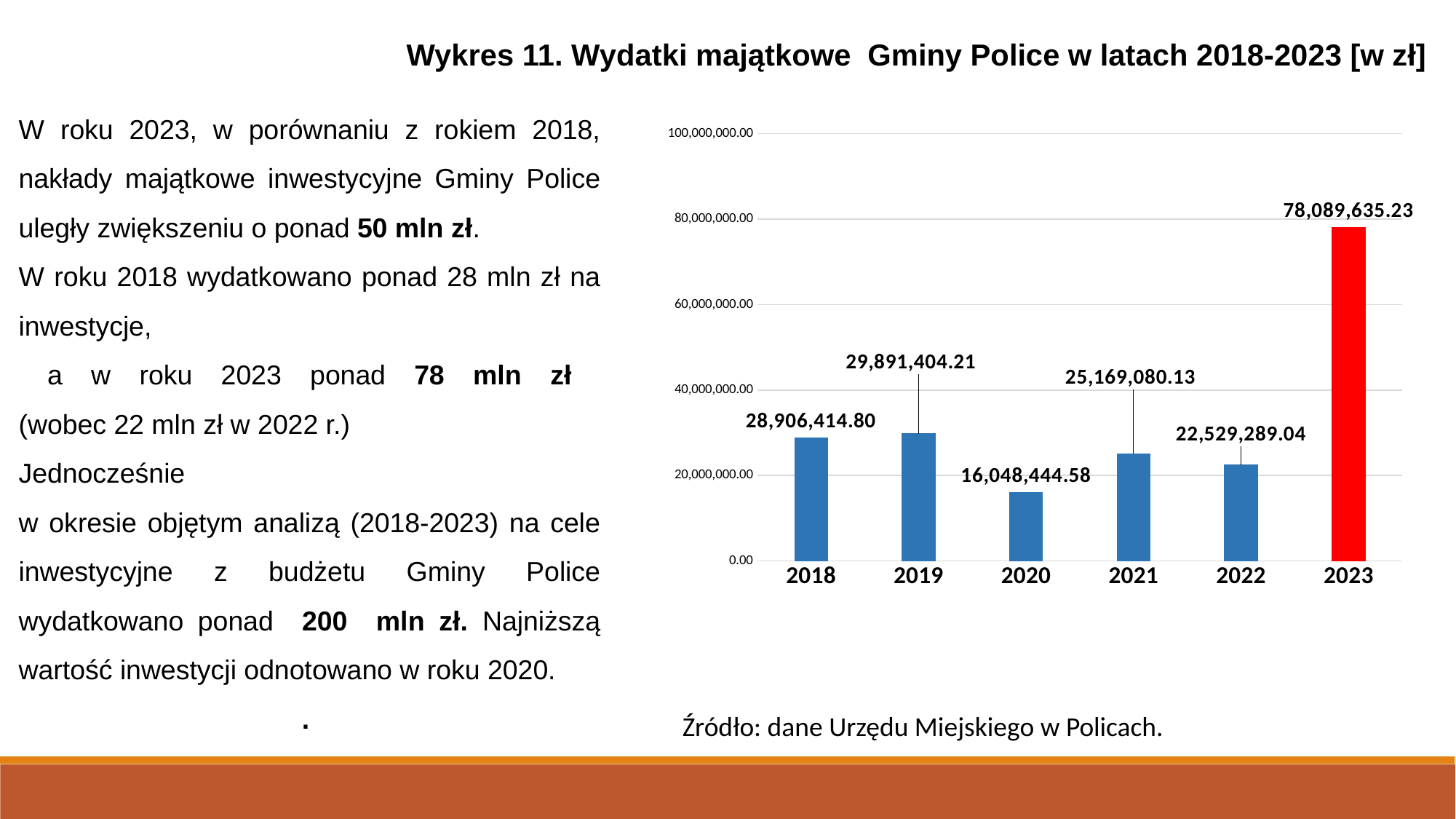
What kind of chart is this? bar chart What is the difference between the values for 2021 and 2022? 2,639,791.09 Which bar is coloured red? 2023 What is the difference between the values for 2023 and 2018? 49,183,220.43 What is the value for 2020? 16,048,444.58 How many years are shown on the x axis? 6 Which is larger, the value for 2018 or the value for 2019? 2019 Which year has the lowest value? 2020 Is the value for 2022 greater or less than 40,000,000.00? less What is the value for 2021? 25,169,080.13 Which year has the highest value? 2023 What is the value for 2023? 78,089,635.23